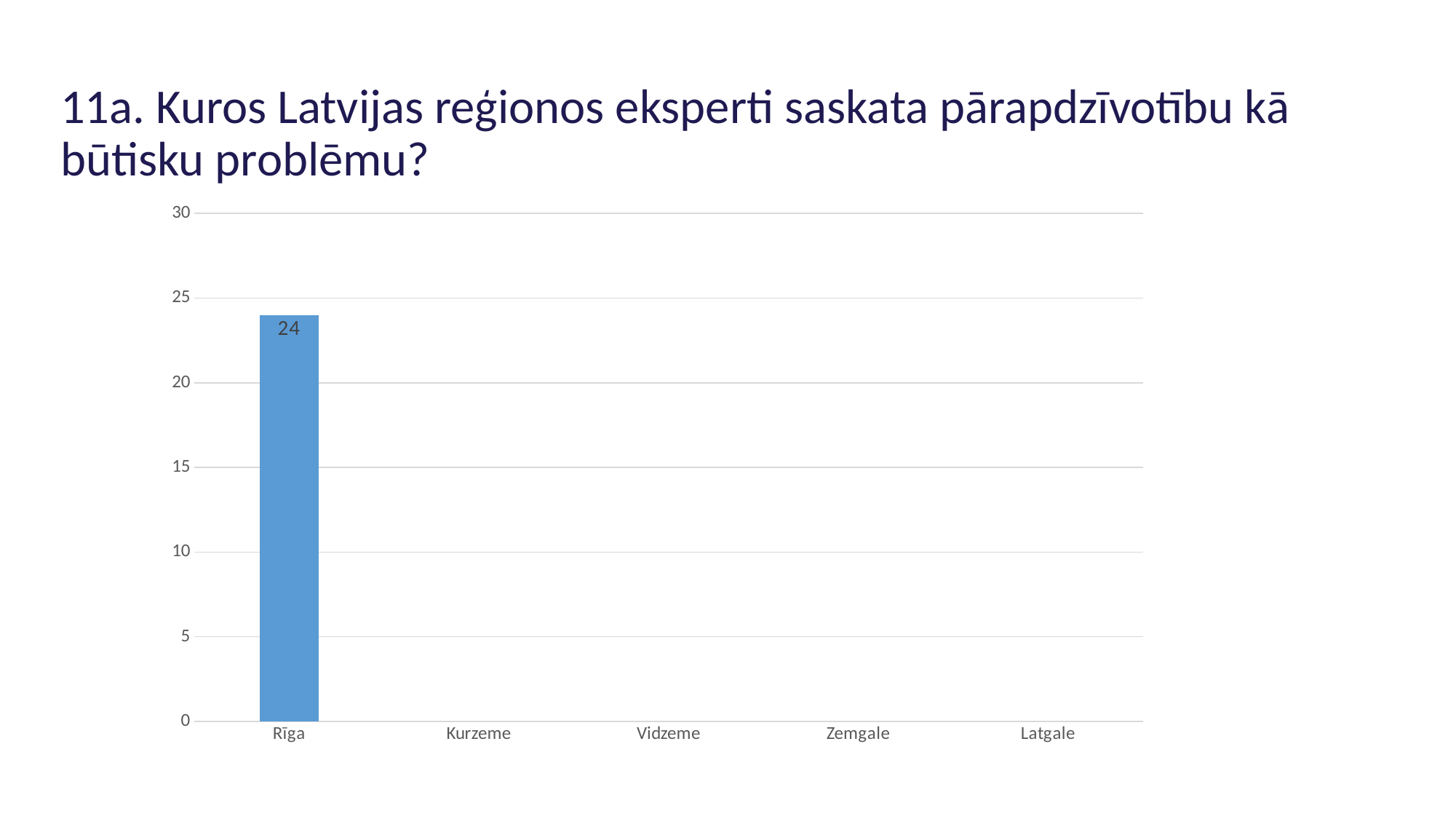
What kind of chart is shown on the slide? bar chart Which region is listed last on the x axis? Latgale Is the value for Rīga greater or less than 25? less What is the highest value shown on the vertical axis? 30 Which region is the only one with a visible bar? Rīga How many regions are listed on the x axis? 5 Is the value for Rīga greater or less than 20? greater What is the value for Rīga? 24 Which region has the highest value? Rīga